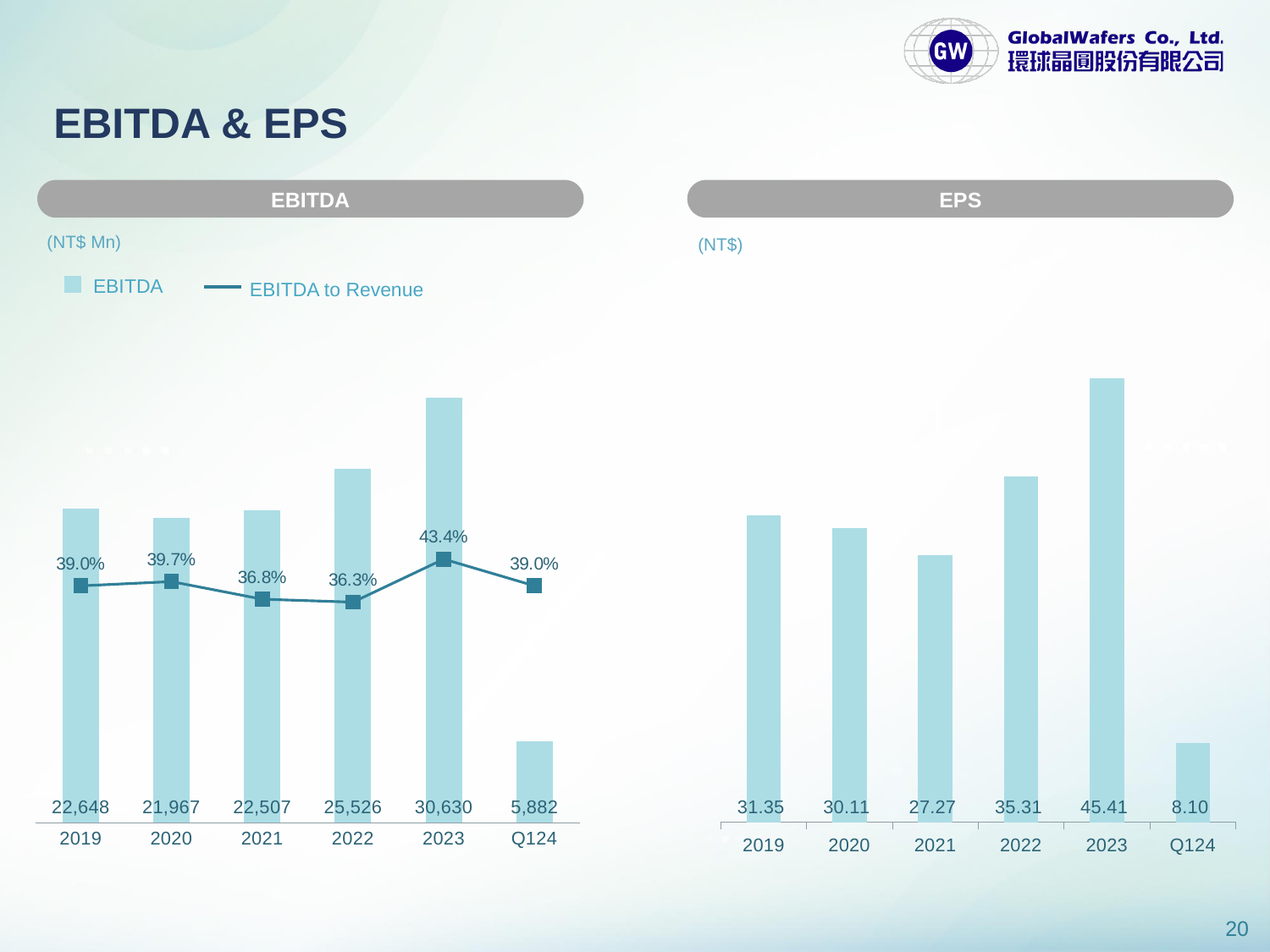
In the EPS chart, which year has the highest EPS? 2023 In the EPS chart, which is larger, the EPS for 2019 or 2020? 2019 In the EBITDA chart, what is the difference in EBITDA between 2023 and 2022? 5,104 In the EBITDA chart, which year has the highest EBITDA to Revenue ratio? 2023 In the EPS chart, how many periods are shown on the x axis? 6 In the EBITDA chart, what is the EBITDA value for 2023? 30,630 In the EBITDA chart, what is the EBITDA to Revenue ratio for 2021? 36.8% In the EBITDA chart, which period has the lowest EBITDA value? Q124 In the EBITDA chart, how many series does the legend list? 2 In the EPS chart, what is the EPS value for 2022? 35.31 What kind of chart is the EPS chart? Bar chart In the EBITDA chart, what is the unit shown for EBITDA? NT$ Mn